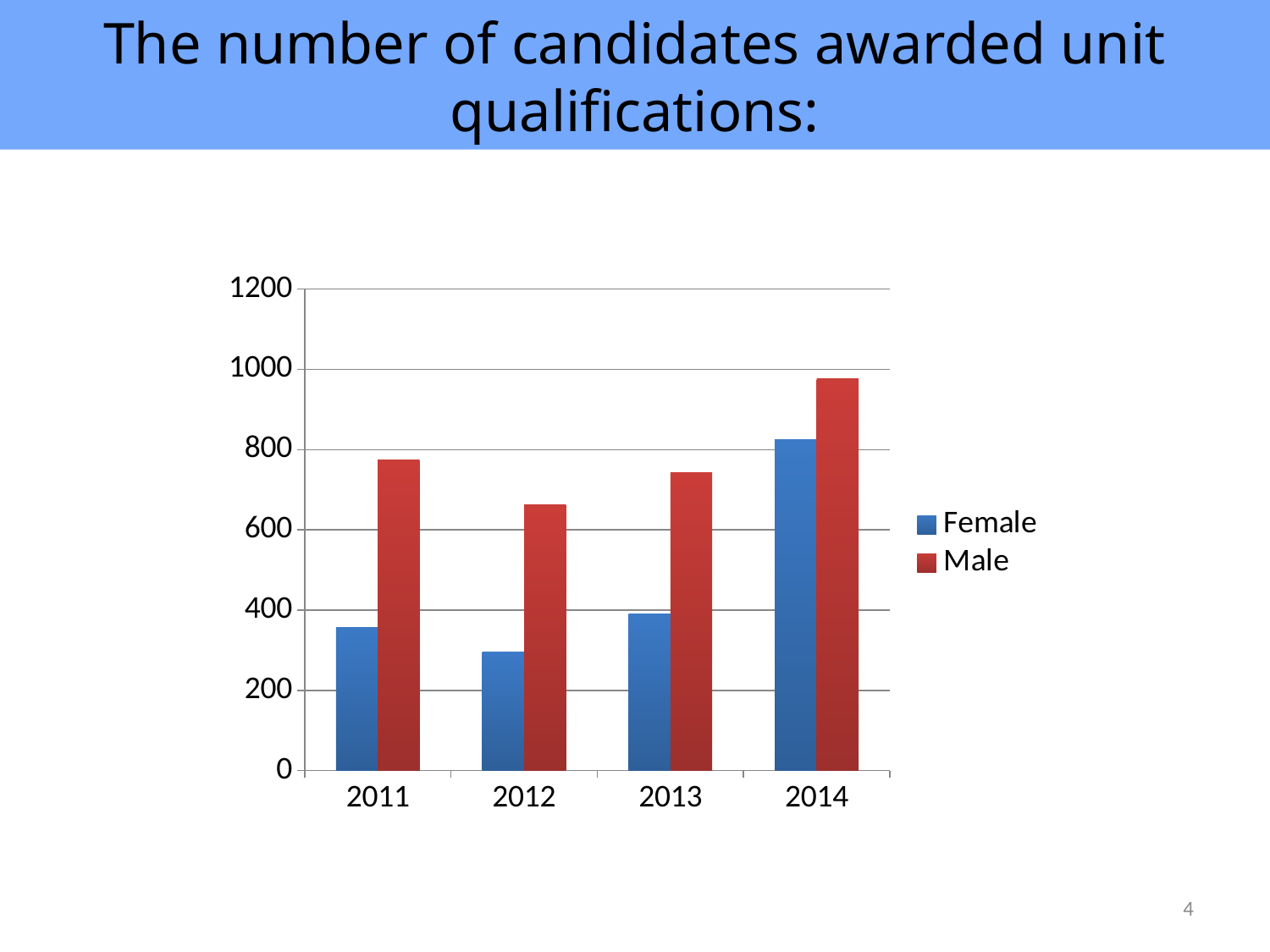
Which year has the highest Male value? 2014 Which year has the lowest Female value? 2012 How many years are shown on the x axis? 4 Which is larger, the Male value for 2011 or the Male value for 2013? 2011 Which is larger in 2013, the Female value or the Male value? Male Is the Female value for 2014 greater or less than 800? greater Which series is shown in blue? Female Is the Male value for 2012 greater or less than 600? greater Is the Female value for 2012 greater or less than 400? less What kind of chart is shown on the slide? bar chart Which year has the lowest Male value? 2012 How many series does the legend list? 2